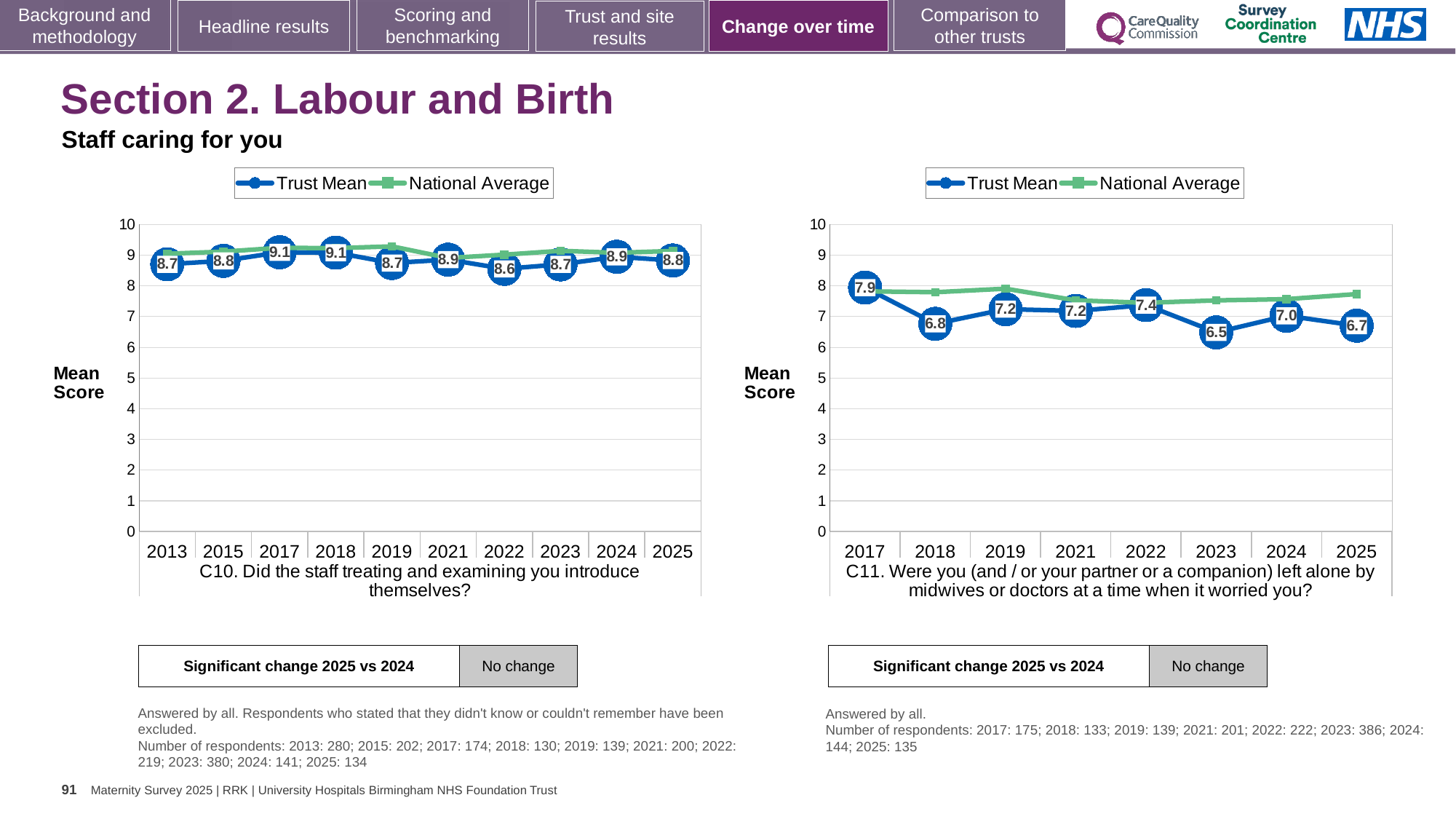
How many years are plotted on the C10 chart (left)? 10 On the C11 chart (right), what is the difference between the Trust Mean scores for 2017 and 2018? 1.1 On the C11 chart (right), what is the Trust Mean score for 2023? 6.5 On the C10 chart (left), what is the Trust Mean score for 2022? 8.6 On the C10 chart (left), what is the Trust Mean score for 2017? 9.1 On the C10 chart (left), which is larger, the Trust Mean score for 2024 or for 2025? 2024 On the C11 chart (right), what is the Trust Mean score for 2025? 6.7 On the C11 chart (right), which year has the lowest Trust Mean score? 2023 On the C11 chart (right), which year has the highest Trust Mean score? 2017 How many series does the legend of the C11 chart (right) list? 2 What type of chart is the C10 chart (left)? Line chart On the C11 chart (right), is the National Average value for 2025 greater or less than 7? greater